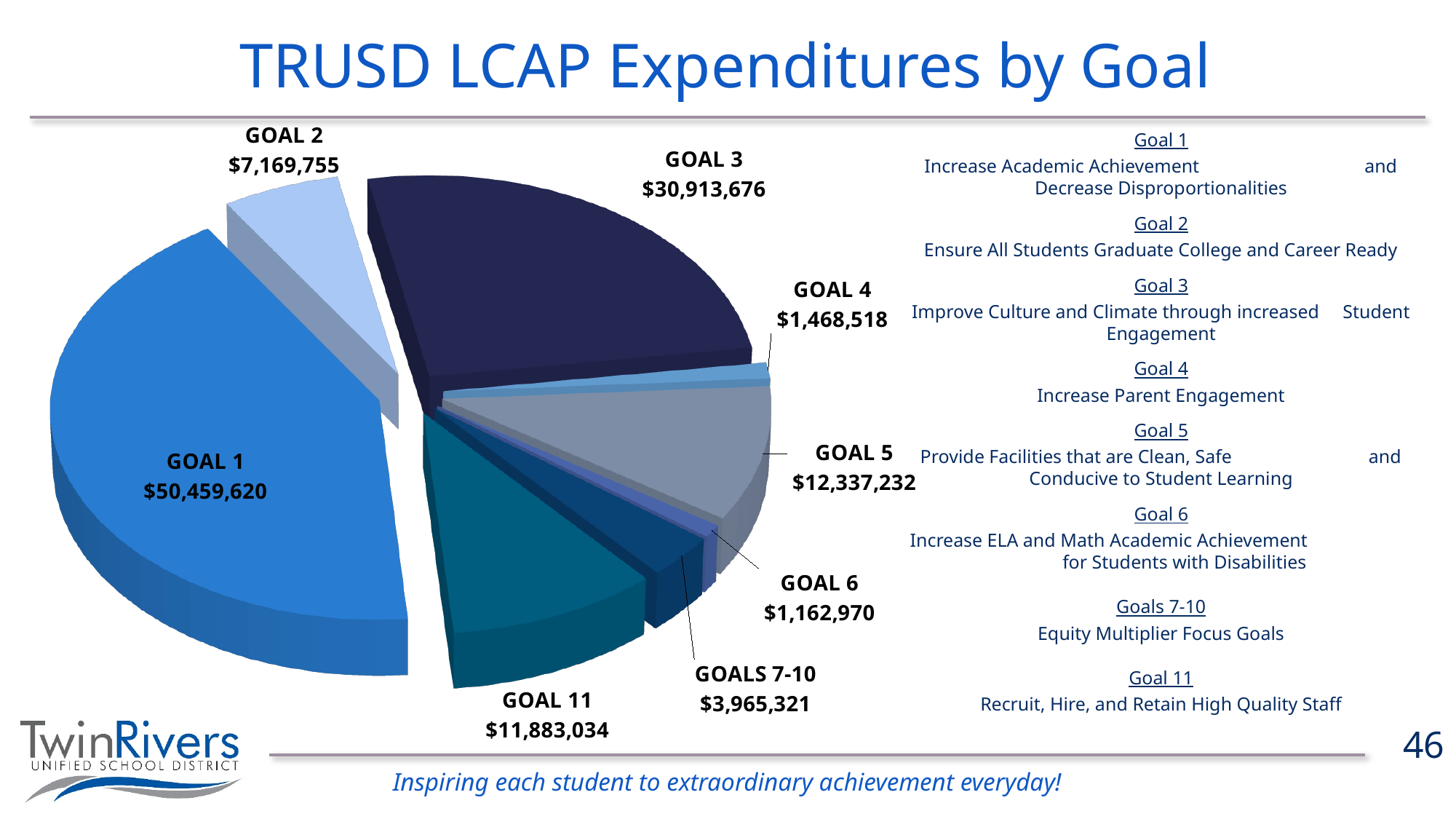
Which goal has the highest expenditure? Goal 1 How many slices does the pie chart have? 8 Which goal has the lowest expenditure? Goal 6 What is the expenditure for Goal 1? $50,459,620 What is the title of the slide's chart? TRUSD LCAP Expenditures by Goal What is the difference between the expenditures for Goal 4 and Goal 6? $305,548 What is the difference between the expenditures for Goal 3 and Goal 5? $18,576,444 What is the expenditure for Goal 5? $12,337,232 What is the expenditure for Goals 7-10? $3,965,321 Which has a larger expenditure, Goal 5 or Goal 11? Goal 5 What kind of chart is shown on the slide? Pie chart Which has a larger expenditure, Goal 2 or Goals 7-10? Goal 2